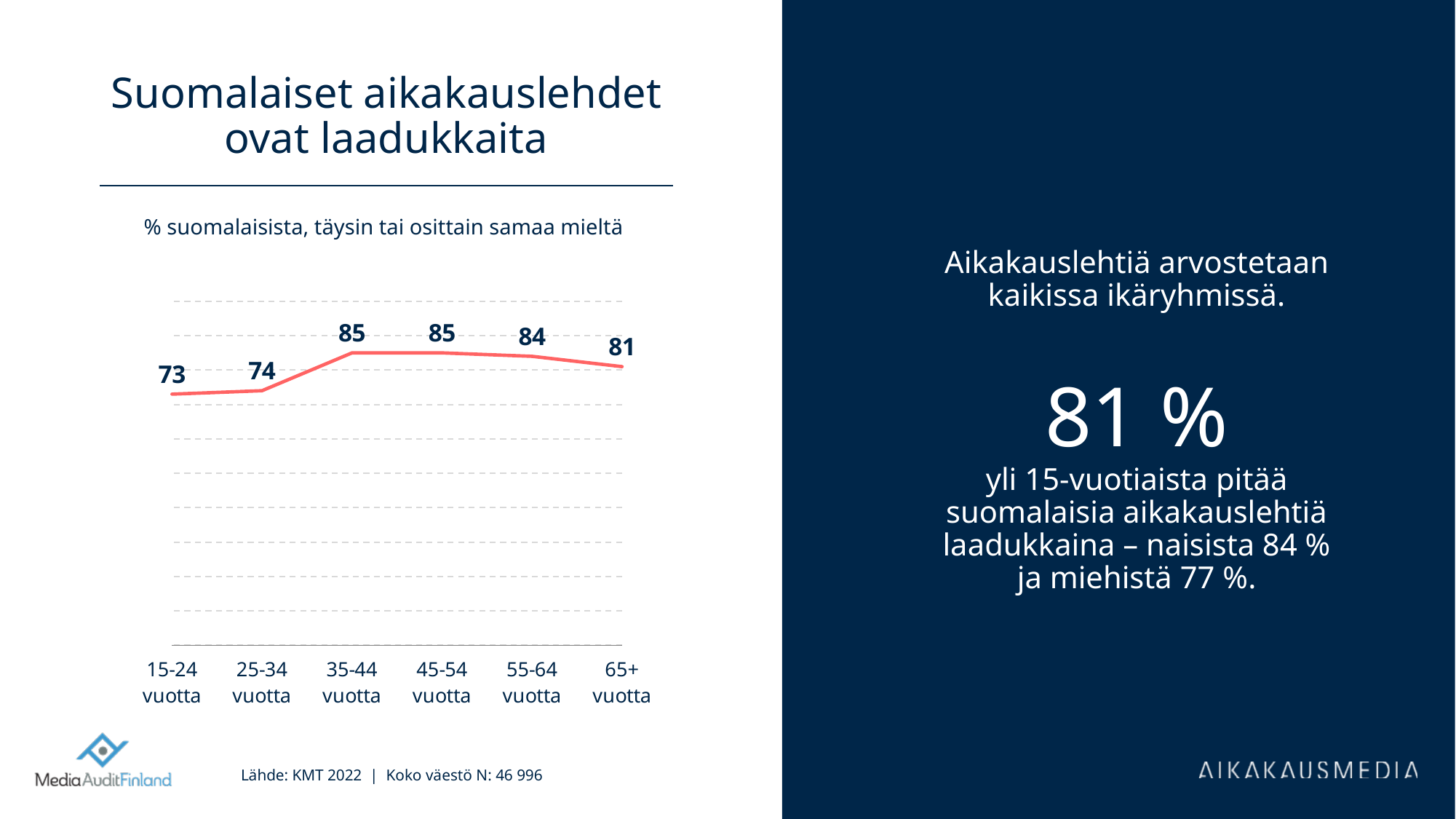
What is the difference between the values for 35-44 vuotta and 15-24 vuotta? 12 What is the value for the 65+ vuotta age group? 81 What is the difference between the values for 55-64 vuotta and 65+ vuotta? 3 What is the value for the 15-24 vuotta age group? 73 How many age groups are plotted on the chart? 6 What kind of chart is shown on the slide? line chart What is the subtitle shown above the chart? % suomalaisista, täysin tai osittain samaa mieltä What is the value for the 55-64 vuotta age group? 84 Which is larger, the value for 25-34 vuotta or the value for 65+ vuotta? 65+ vuotta Do the values rise or fall from 15-24 vuotta to 35-44 vuotta? rise Which age group has the lowest value? 15-24 vuotta Do the values rise or fall from 45-54 vuotta to 65+ vuotta? fall